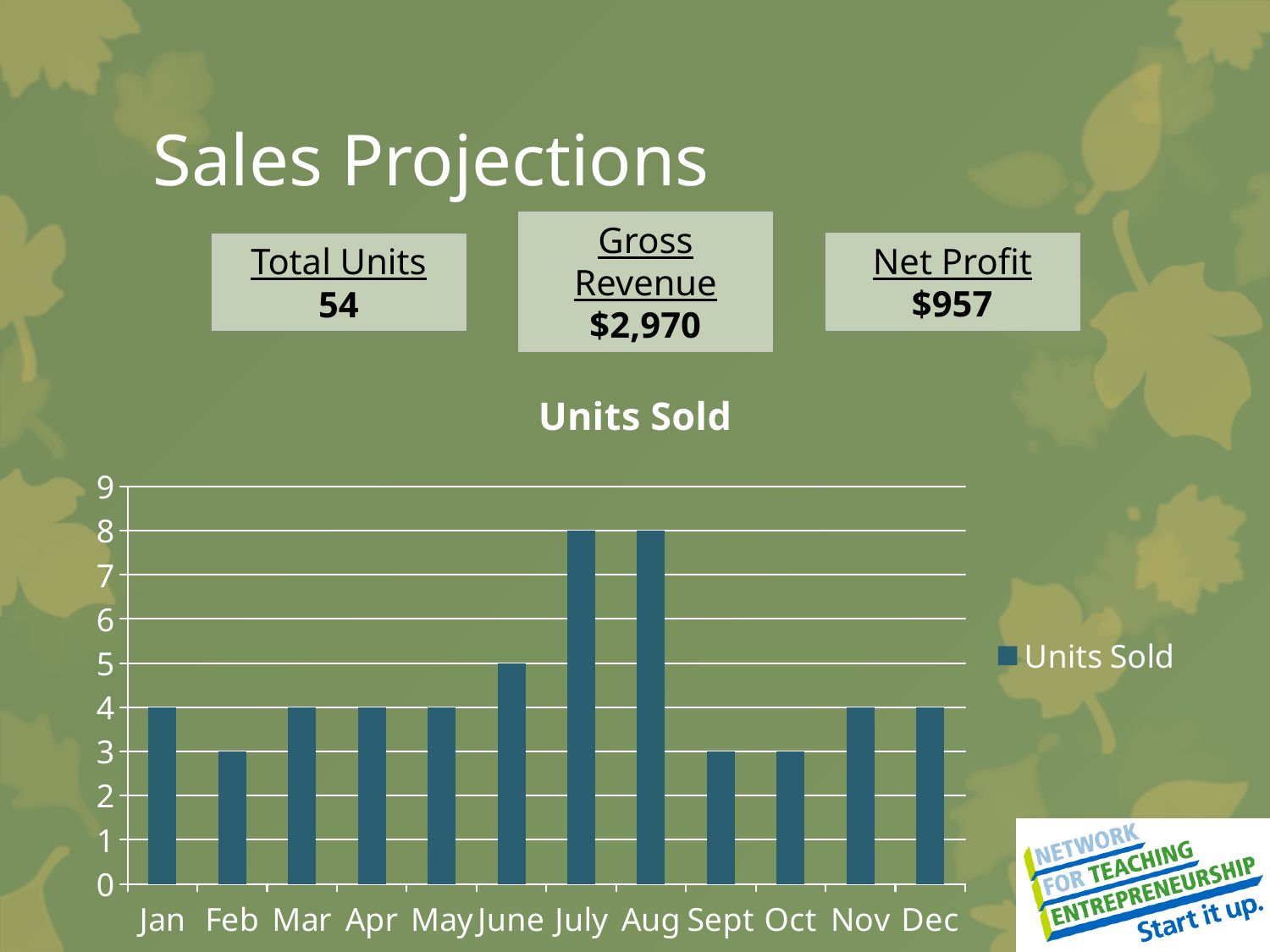
Which month has more units sold, July or Oct? July How many units were sold in July according to the Units Sold chart? 8 How many months are shown on the x axis of the Units Sold chart? 12 Do the units sold rise or fall from Aug to Sept? fall What type of chart is shown on the slide? bar chart Is the value for Aug greater or less than 6? greater How many series does the legend of the Units Sold chart list? 1 How many units were sold in Dec according to the Units Sold chart? 4 What is the difference in units sold between June and May? 1 How many units were sold in Feb according to the Units Sold chart? 3 How many units were sold in June according to the Units Sold chart? 5 What is the difference in units sold between Aug and Sept? 5